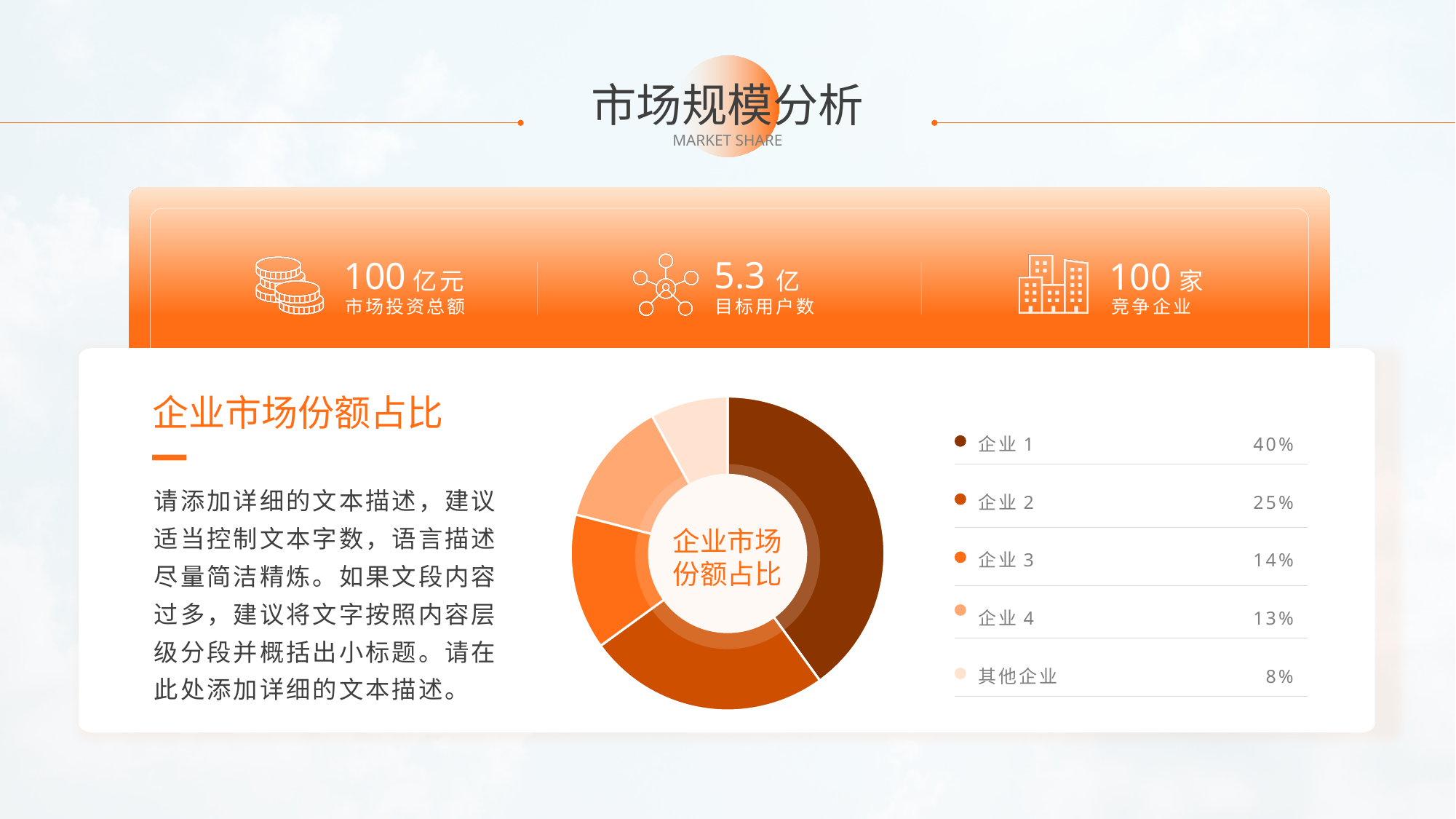
What share of the market does 企业 1 hold in the 企业市场份额占比 chart? 40% What is the difference between the shares of 企业 3 and 其他企业 in the 企业市场份额占比 chart? 6% What is the combined share of 企业 1 and 企业 2 in the 企业市场份额占比 chart? 65% Which category has the smallest share in the 企业市场份额占比 chart? 其他企业 Which category has the largest share in the 企业市场份额占比 chart? 企业 1 What type of chart is the 企业市场份额占比 chart? Donut (pie) chart In the 企业市场份额占比 chart, which has a larger share, 企业 2 or 企业 4? 企业 2 How many categories are shown in the 企业市场份额占比 chart? 5 What percentage is listed for 其他企业 in the 企业市场份额占比 chart? 8% What is the value shown for 企业 3 in the 企业市场份额占比 chart? 14% What is the difference between the shares of 企业 1 and 企业 2 in the 企业市场份额占比 chart? 15% What text is shown in the centre of the donut chart? 企业市场份额占比